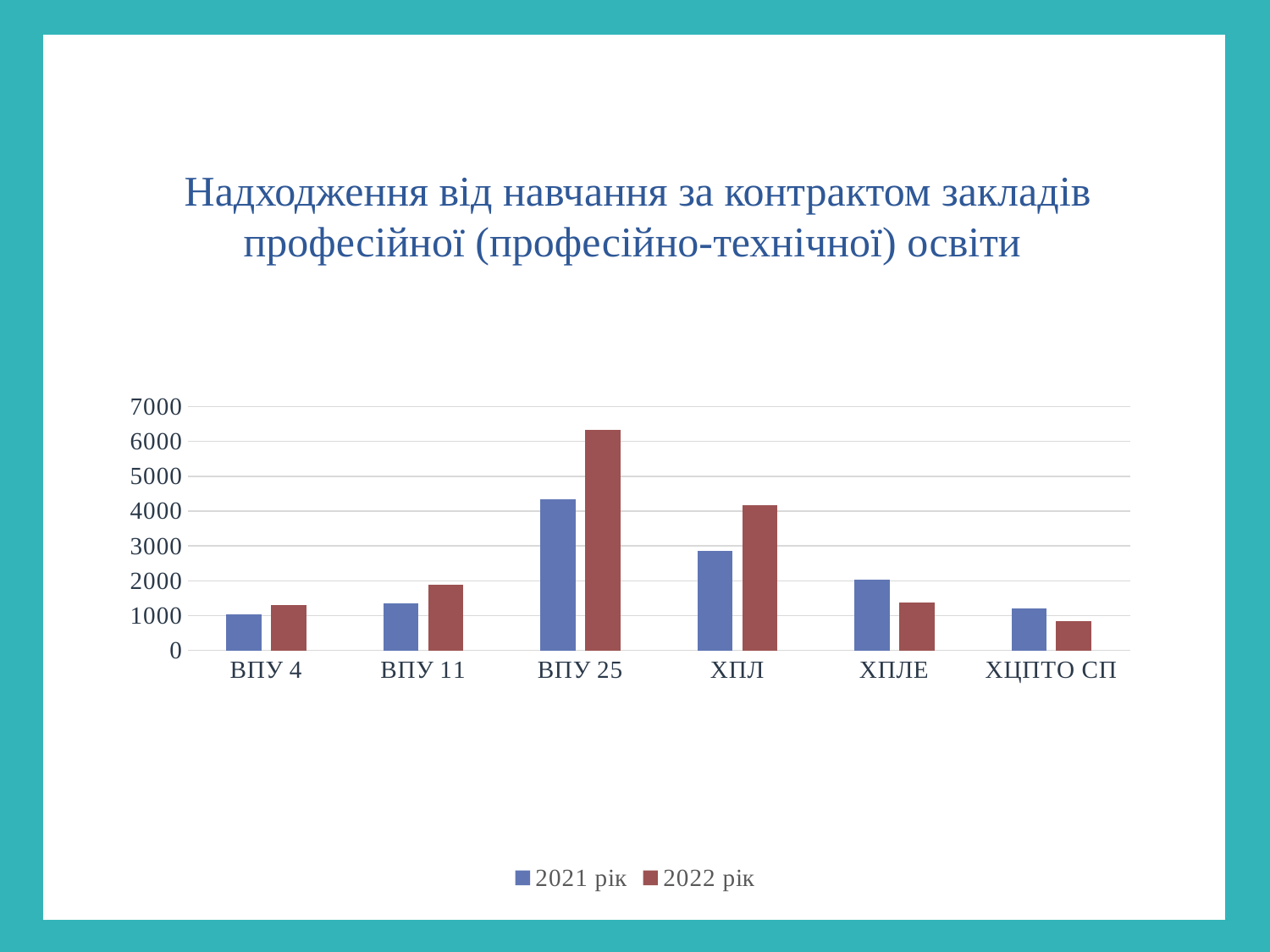
Which institution has the highest value for 2022 рік? ВПУ 25 Which is larger: the 2022 рік value for ВПУ 25 or the 2022 рік value for ХПЛ? ВПУ 25 How many series does the legend list? 2 Which colour represents the 2022 рік series in the legend? Red How many institutions (categories) are shown on the x axis? 6 What kind of chart is shown on the slide? Bar chart Which institution has the lowest value for 2022 рік? ХЦПТО СП Is the 2022 рік value for ХЦПТО СП greater or less than 1000? less Which institution has the highest value for 2021 рік? ВПУ 25 Is the 2021 рік value for ХПЛ greater or less than 3000? less For ХПЛЕ, which series has the larger value, 2021 рік or 2022 рік? 2021 рік Is the 2022 рік value for ВПУ 25 greater or less than 6000? greater